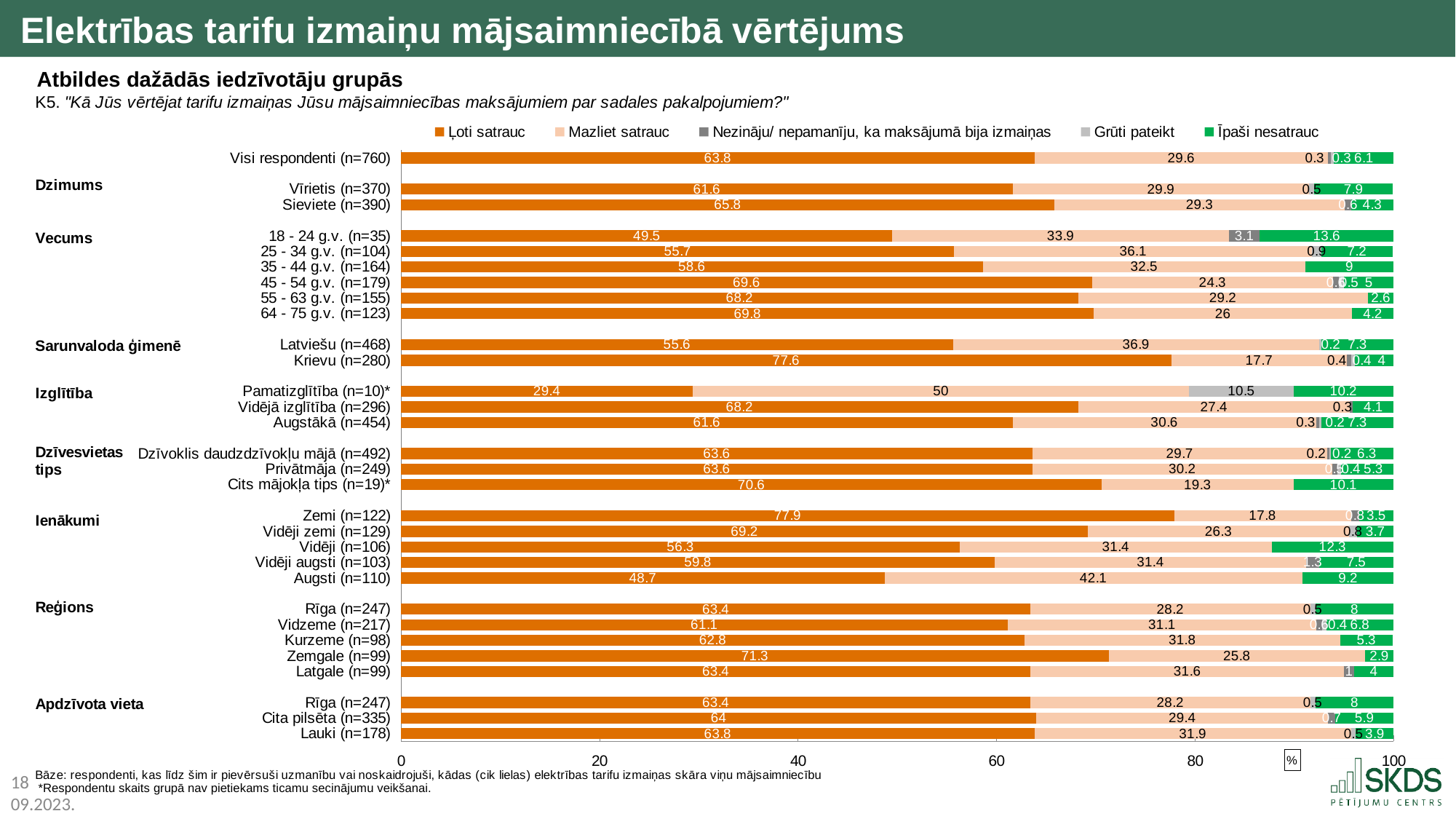
What is the 'Īpaši nesatrauc' value for 18 - 24 g.v. (n=35)? 13.6 How many series does the legend list? 5 What is the 'Ļoti satrauc' value for Visi respondenti (n=760)? 63.8 How many respondent groups (bars) are shown in the chart? 30 What is the difference between the 'Ļoti satrauc' values for Sieviete (n=390) and Vīrietis (n=370)? 4.2 Which has a larger 'Ļoti satrauc' value, Latviešu (n=468) or Krievu (n=280)? Krievu (n=280) Which group has the highest 'Mazliet satrauc' value? Pamatizglītība (n=10)* What is the 'Mazliet satrauc' value for Augsti (n=110)? 42.1 Is the 'Ļoti satrauc' value for Zemgale (n=99) greater or less than 60? greater Which group has the lowest 'Ļoti satrauc' value? Pamatizglītība (n=10)* What is the 'Grūti pateikt' value for Pamatizglītība (n=10)*? 10.5 What kind of chart is shown on the slide? Stacked bar chart